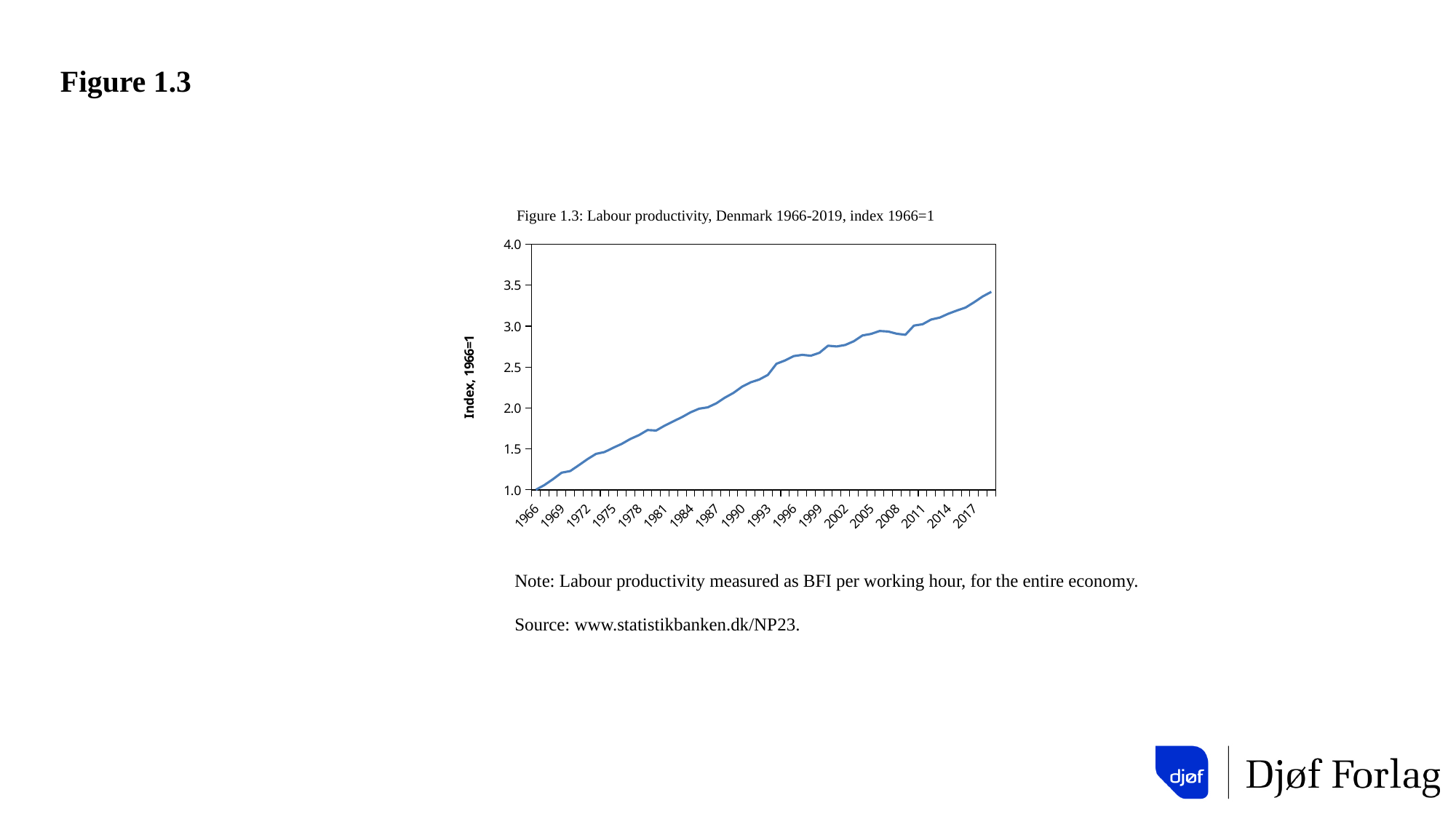
In which year is the labour productivity index lowest? 1966 Is the value for 2005 greater or less than 2.5? greater What kind of chart is shown on the slide? line chart Is the value for 1990 greater or less than 2.5? less Is the value for 1981 greater or less than 2.0? less In which year is the labour productivity index highest? 2019 What is the title of the chart? Figure 1.3: Labour productivity, Denmark 1966-2019, index 1966=1 How many data series are plotted in the chart? 1 Does the labour productivity index generally rise or fall from 1966 to 2019? rise What is the label on the vertical axis of the chart? Index, 1966=1 What is the value of the labour productivity index in 1966? 1.0